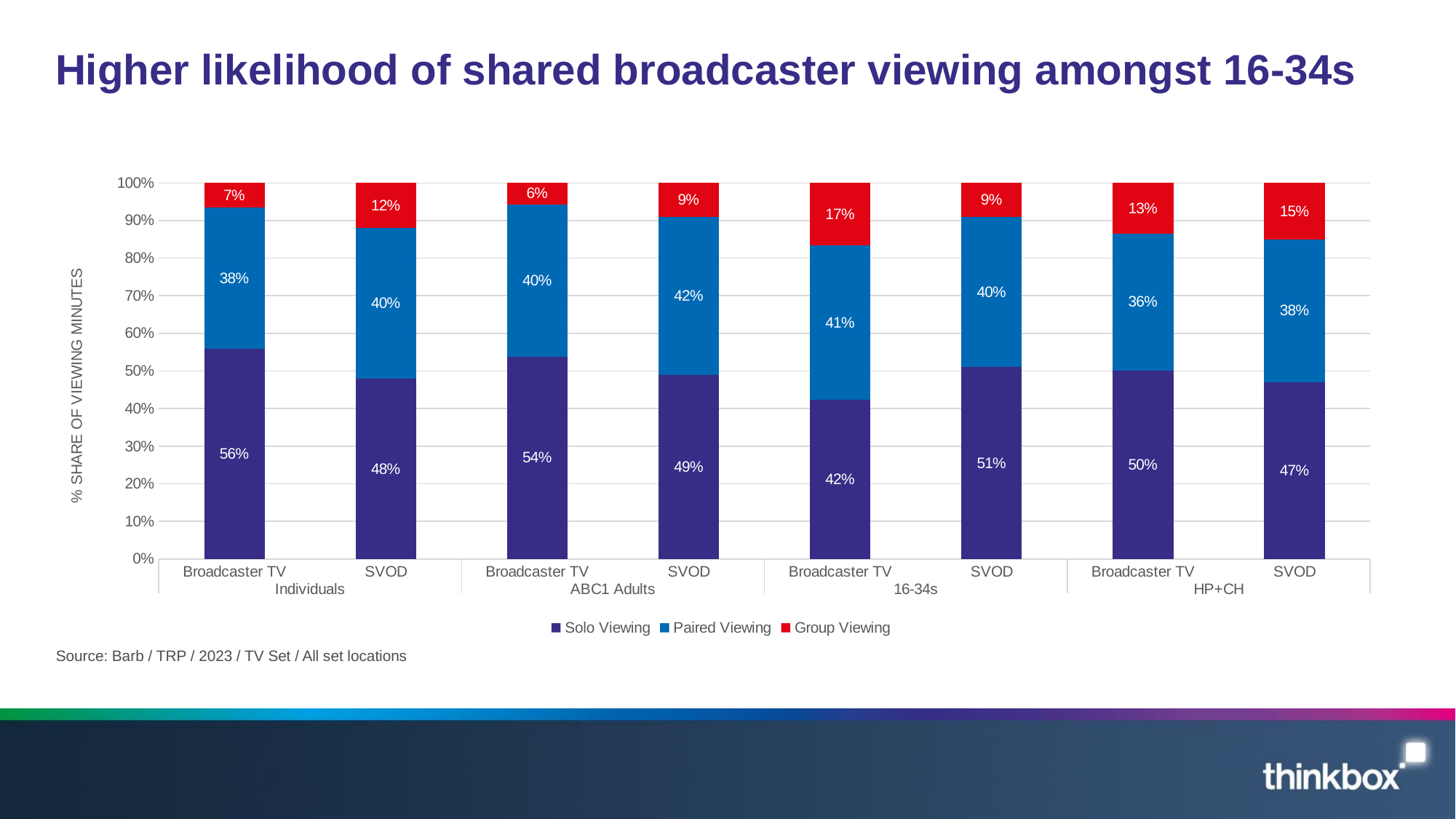
How many series does the legend list? 3 Is the Group Viewing share larger for Broadcaster TV or SVOD among 16-34s? Broadcaster TV What is the label on the vertical axis? % SHARE OF VIEWING MINUTES How many bars are shown in the chart? 8 What is the Solo Viewing share for Broadcaster TV among 16-34s? 42% What is the Group Viewing share for SVOD among Individuals? 12% Which bar has the lowest Solo Viewing share? Broadcaster TV, 16-34s What is the Group Viewing share for Broadcaster TV among HP+CH? 13% What is the Paired Viewing share for SVOD among ABC1 Adults? 42% What kind of chart is shown on the slide? Stacked bar chart Which bar has the highest Group Viewing share? Broadcaster TV, 16-34s What is the difference between the Solo Viewing share for Broadcaster TV among Individuals and among 16-34s? 14 percentage points